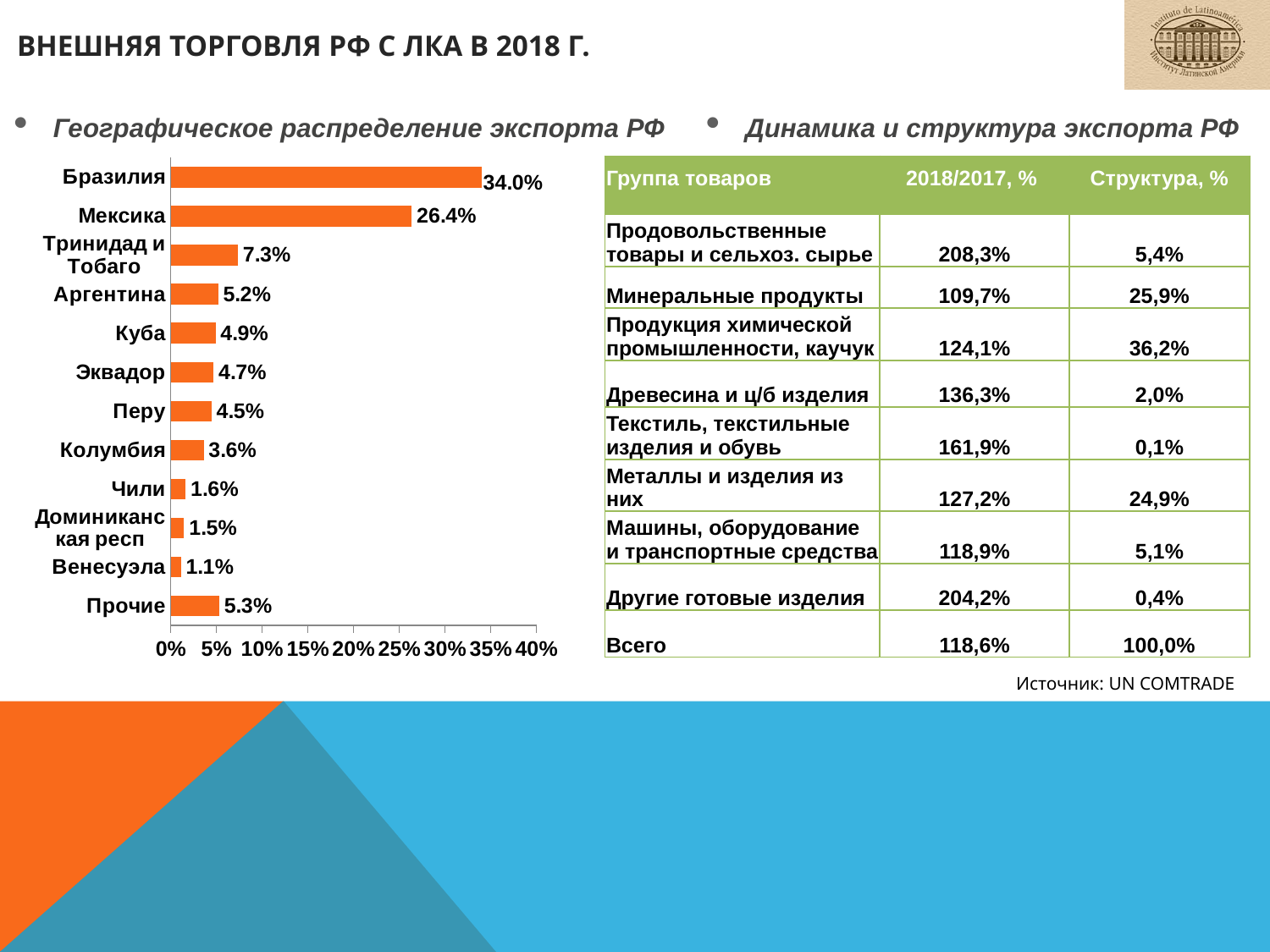
What is the value for Тринидад и Тобаго in the bar chart? 7.3% What is the value for Венесуэла in the bar chart? 1.1% Which is larger in the bar chart, the value for Аргентина or the value for Куба? Аргентина What is the difference between the values for Бразилия and Мексика in the bar chart? 7.6% Which category has the highest value in the bar chart? Бразилия How many categories are shown in the bar chart? 12 What is the title of the bar chart? Географическое распределение экспорта РФ Is the value for Мексика in the bar chart greater or less than 25%? greater What type of chart is shown on the slide? bar chart What is the value for Мексика in the bar chart? 26.4% Which category has the lowest value in the bar chart? Венесуэла What is the value for Бразилия in the bar chart? 34.0%